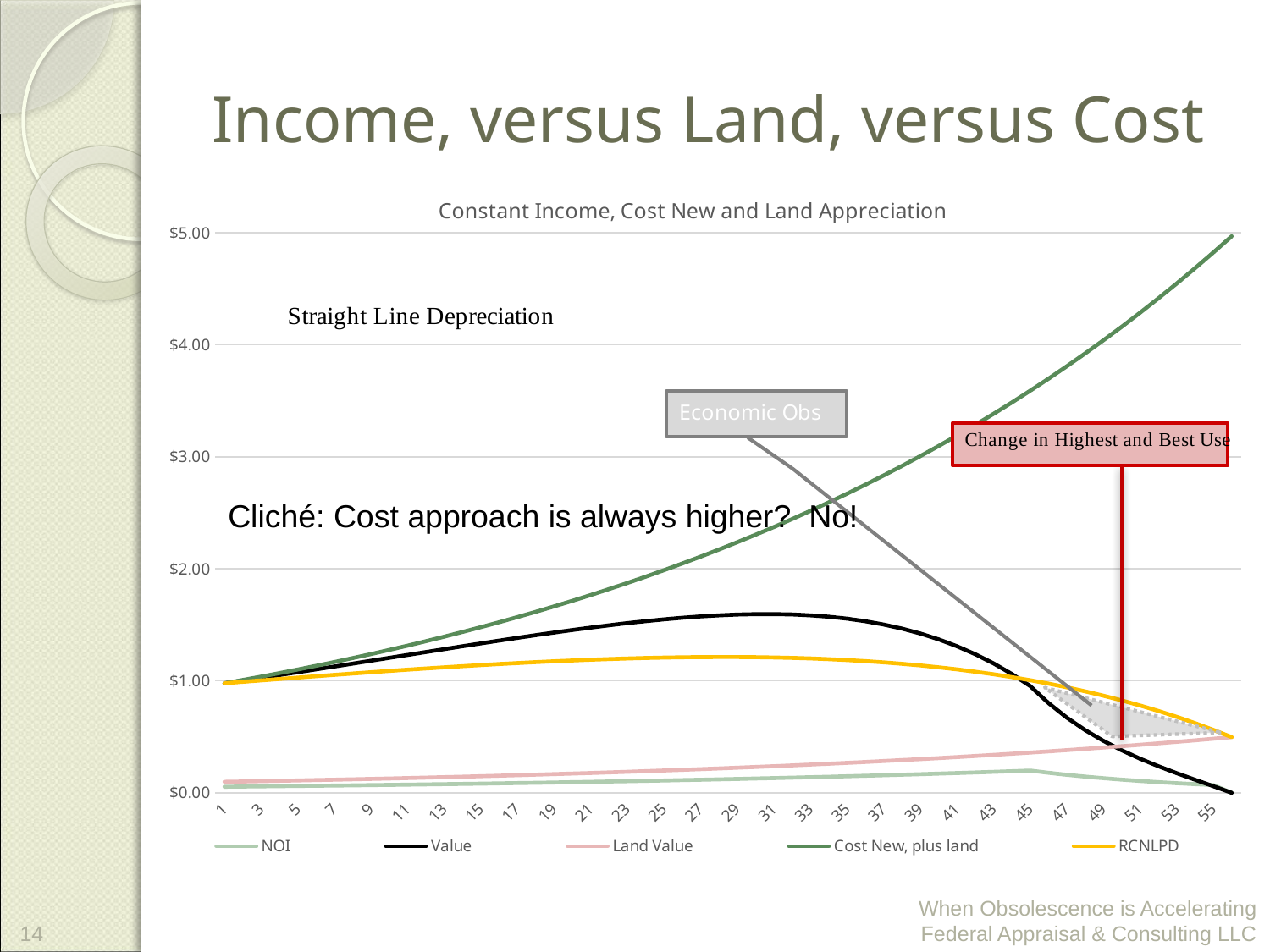
Does the Value series rise or fall between x = 45 and x = 55? fall What kind of chart is shown on the slide? line chart Is the RCNLPD series at x = 31 greater or less than $2.00? less Is the value of 'Cost New, plus land' at x = 55 greater or less than $4.00? greater Is the Value series at x = 55 greater or less than $1.00? less How many series does the chart legend list? 5 Which colour is used for the Value series in the chart? black At x = 31, which is higher, the Value series or the RCNLPD series? Value Which series has the highest value at x = 55? Cost New, plus land Does the 'Cost New, plus land' series rise or fall along the x axis? rise What is the title of the chart? Constant Income, Cost New and Land Appreciation